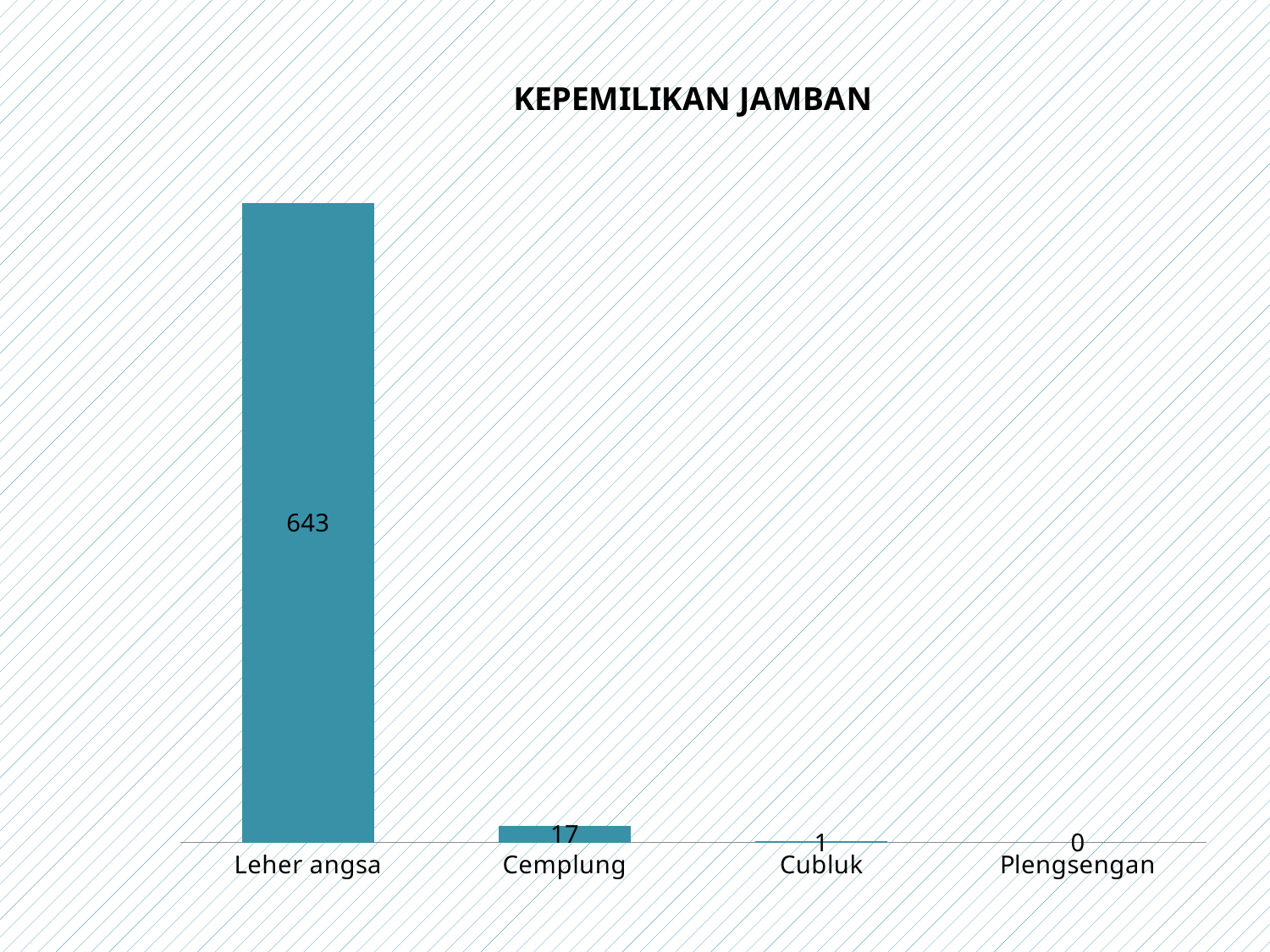
What kind of chart is this? Bar chart What is the value for Plengsengan? 0 What is the value for Leher angsa? 643 What is the difference between the values for Cemplung and Cubluk? 16 What is the value for Cubluk? 1 How many categories are shown on the x axis? 4 Which category has the highest value? Leher angsa Which category has the lowest value? Plengsengan What is the difference between the values for Leher angsa and Cemplung? 626 Which is larger, the value for Cemplung or the value for Cubluk? Cemplung What is the title of the chart? KEPEMILIKAN JAMBAN What is the value for Cemplung? 17